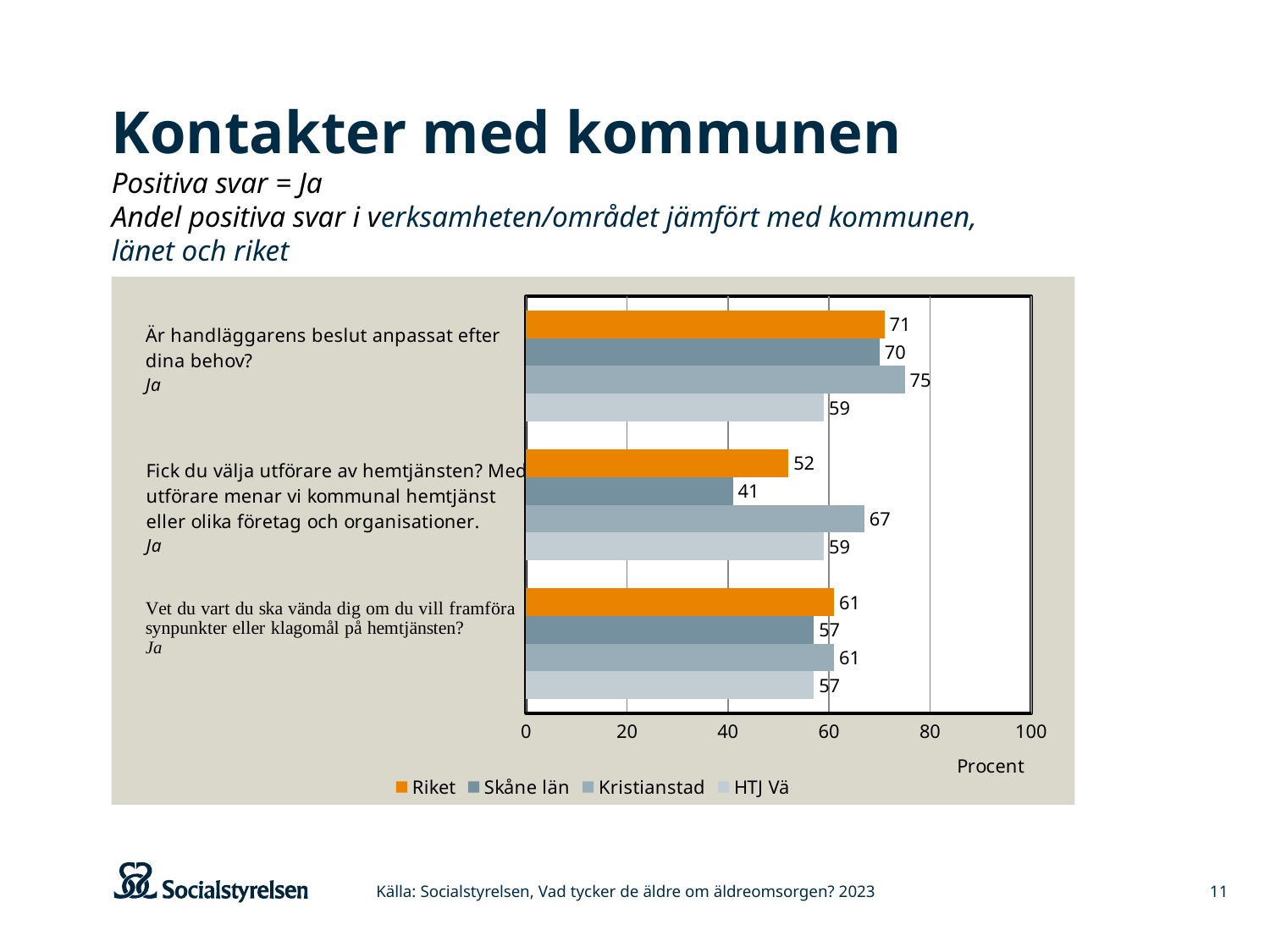
What kind of chart is shown on the slide? bar chart What is the value for HTJ Vä on "Vet du vart du ska vända dig om du vill framföra synpunkter eller klagomål på hemtjänsten?"? 57 What is the value for Riket on "Vet du vart du ska vända dig om du vill framföra synpunkter eller klagomål på hemtjänsten?"? 61 What label is shown on the horizontal axis of the chart? Procent Which series has the lowest value on "Är handläggarens beslut anpassat efter dina behov?"? HTJ Vä How many question categories are plotted on the chart? 3 Which is larger on "Är handläggarens beslut anpassat efter dina behov?": Riket or HTJ Vä? Riket What is the difference between Kristianstad and Skåne län on "Fick du välja utförare av hemtjänsten?"? 26 What is the value for Kristianstad on "Är handläggarens beslut anpassat efter dina behov?"? 75 How many series does the legend list? 4 Which series has the highest value on "Fick du välja utförare av hemtjänsten?"? Kristianstad What is the value for Skåne län on "Fick du välja utförare av hemtjänsten?"? 41